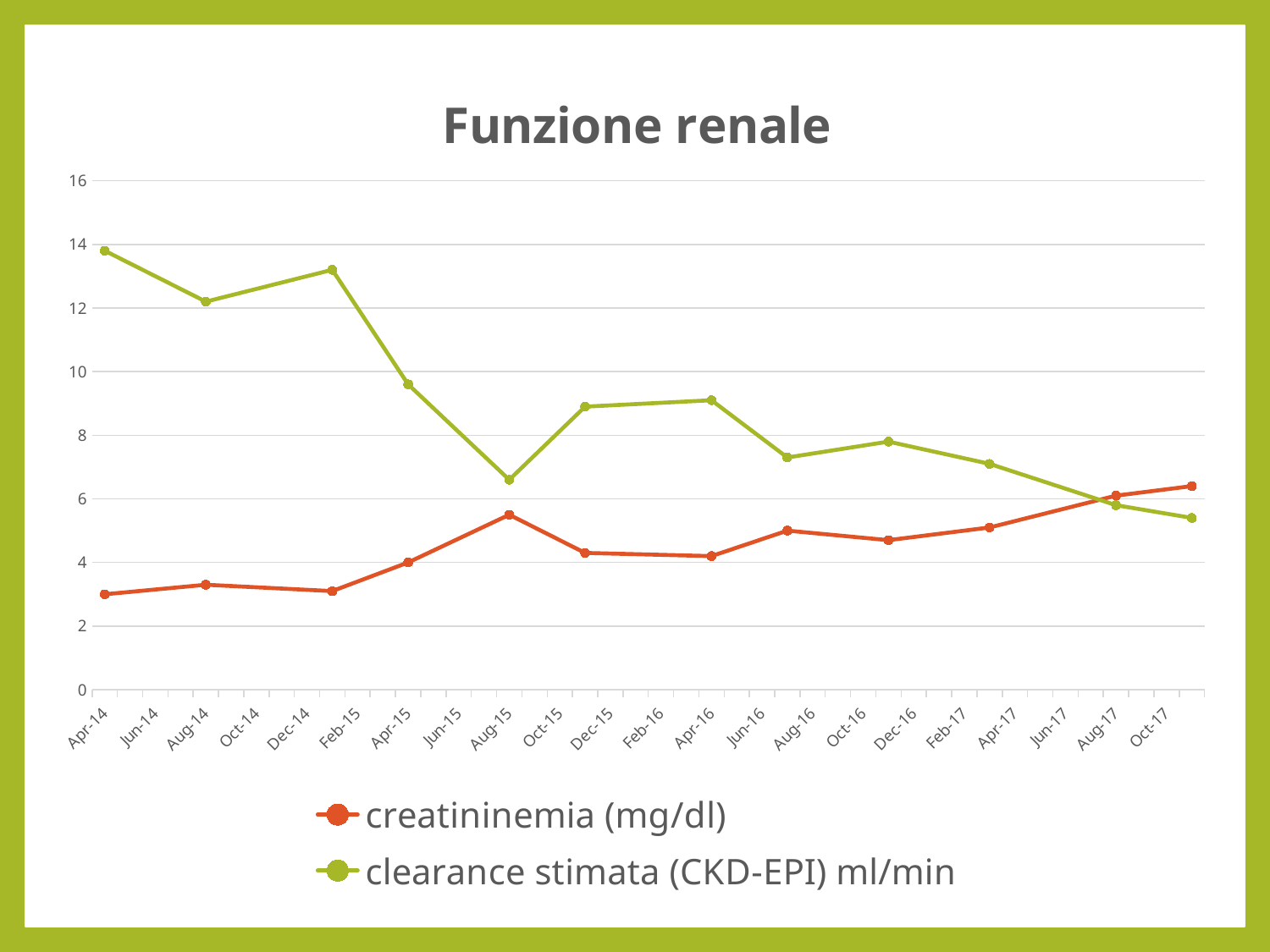
Does the clearance stimata (CKD-EPI) ml/min series generally rise or fall from Apr-14 to Oct-17? fall How many series does the legend list? 2 Is the clearance stimata (CKD-EPI) ml/min value at Apr-14 greater or less than 12? greater What is the title of the chart? Funzione renale Is the creatininemia (mg/dl) value at Apr-14 greater or less than 4? less Does the creatininemia (mg/dl) series generally rise or fall from Apr-14 to Oct-17? rise At Oct-17, which series has the higher value, creatininemia (mg/dl) or clearance stimata (CKD-EPI) ml/min? creatininemia (mg/dl) Which series is drawn in green? clearance stimata (CKD-EPI) ml/min What kind of chart is shown on the slide? line chart At which date is the clearance stimata (CKD-EPI) ml/min value highest? Apr-14